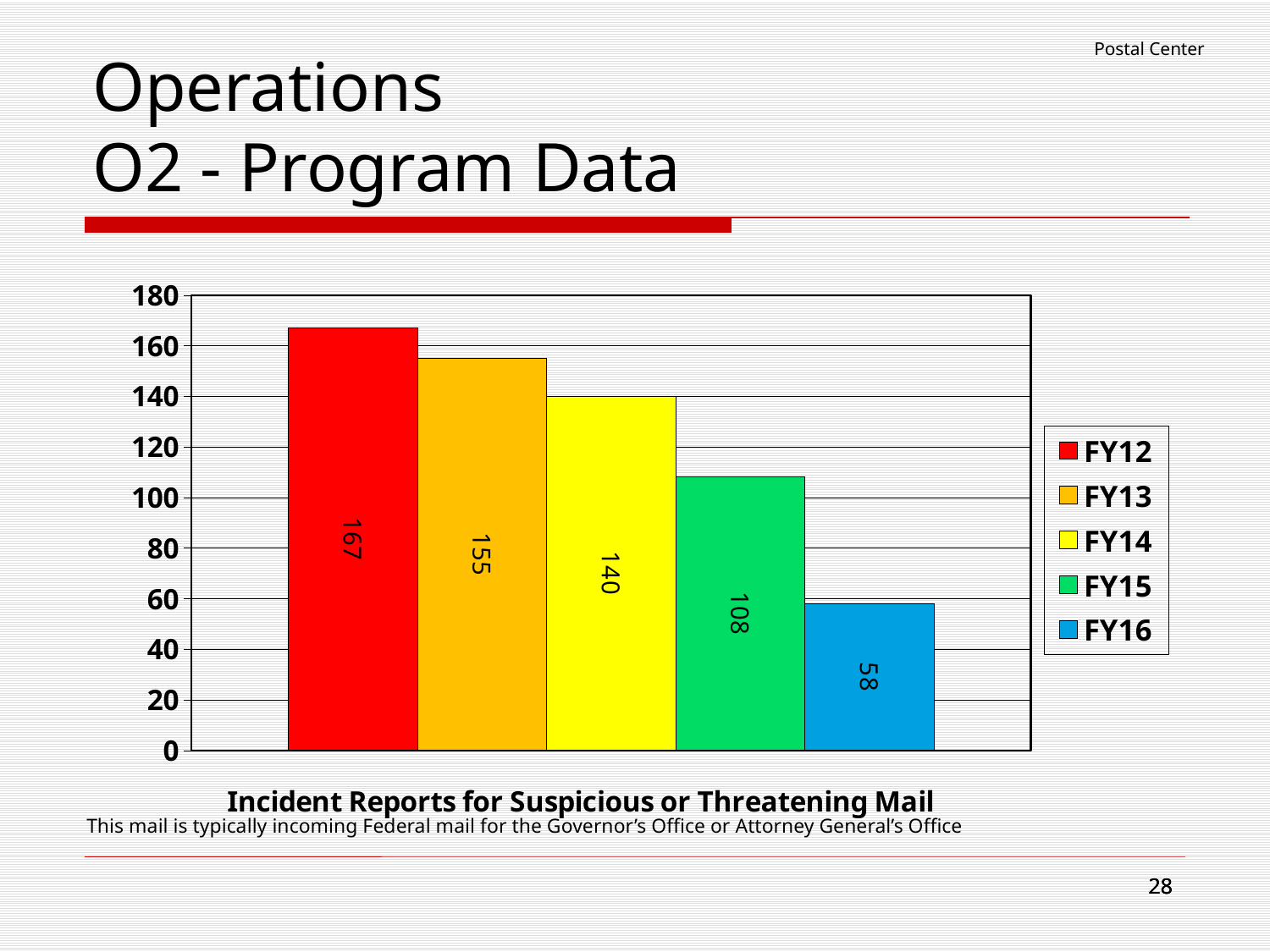
Is the value for FY13 greater or less than 140? greater What is the value for FY12? 167 What is the difference between the values for FY12 and FY16? 109 Do the values rise or fall from FY12 to FY16? fall What is the value for FY16? 58 Which fiscal year has the lowest value? FY16 What kind of chart is shown on the slide? bar chart What is the value for FY15? 108 Which is larger, the value for FY14 or the value for FY15? FY14 Which fiscal year has the highest value? FY12 What is the difference between the values for FY13 and FY14? 15 How many series does the legend list? 5